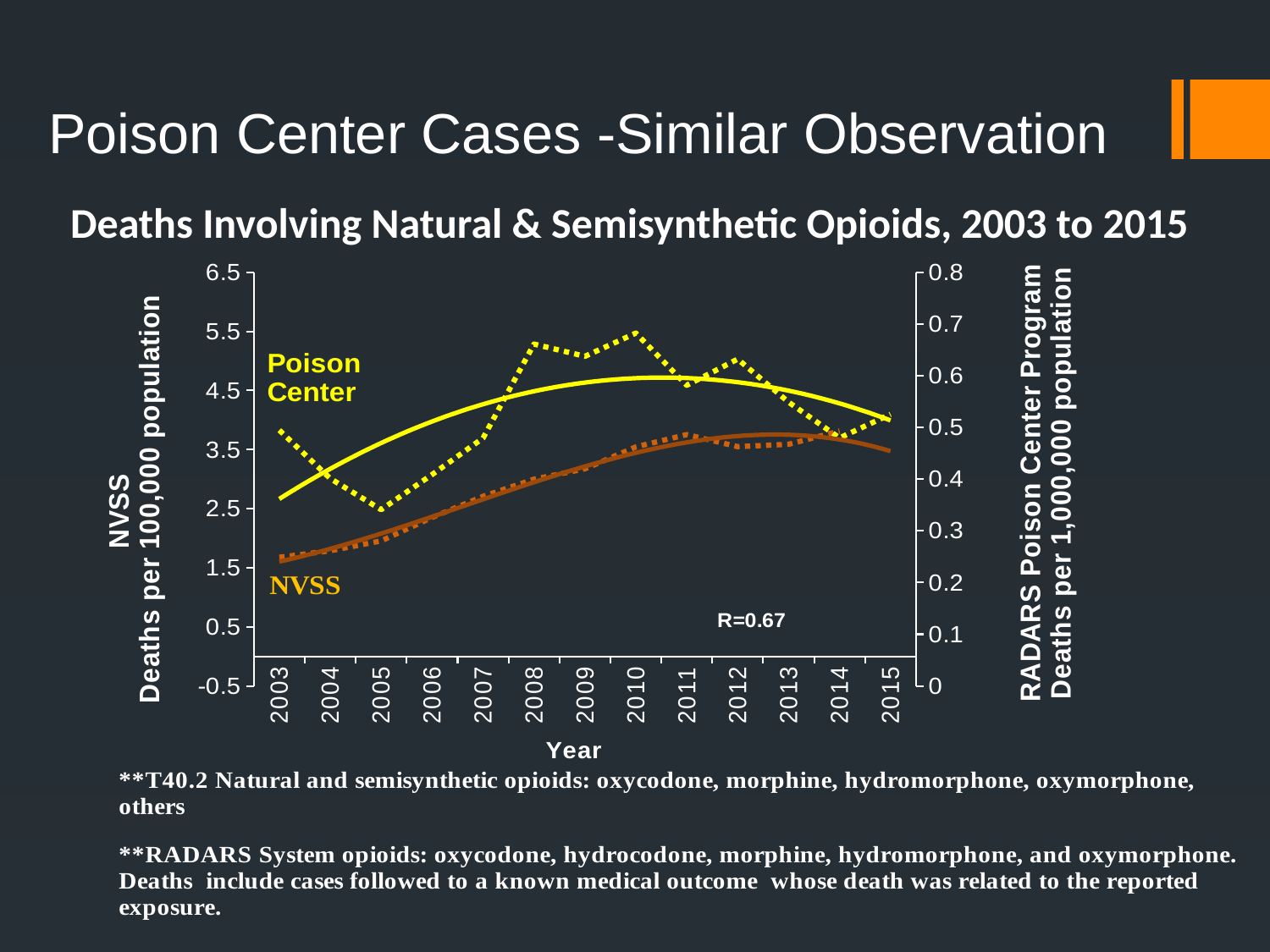
What correlation value is annotated on the chart? R=0.67 In which year is the NVSS series at its lowest? 2003 How many years are plotted along the x axis of the chart? 13 What kind of chart is shown on the slide? Line chart What is the title of the chart? Deaths Involving Natural & Semisynthetic Opioids, 2003 to 2015 Is the Poison Center value for 2010 greater or less than 0.6 deaths per 1,000,000 population on the right axis? greater Does the NVSS series rise or fall from 2003 to 2011? Rise Which year has the larger Poison Center value, 2005 or 2010? 2010 Is the NVSS value for 2003 greater or less than 2.5 deaths per 100,000 population? less Which two data series are labelled on the chart? Poison Center and NVSS In which year is the Poison Center series at its lowest? 2005